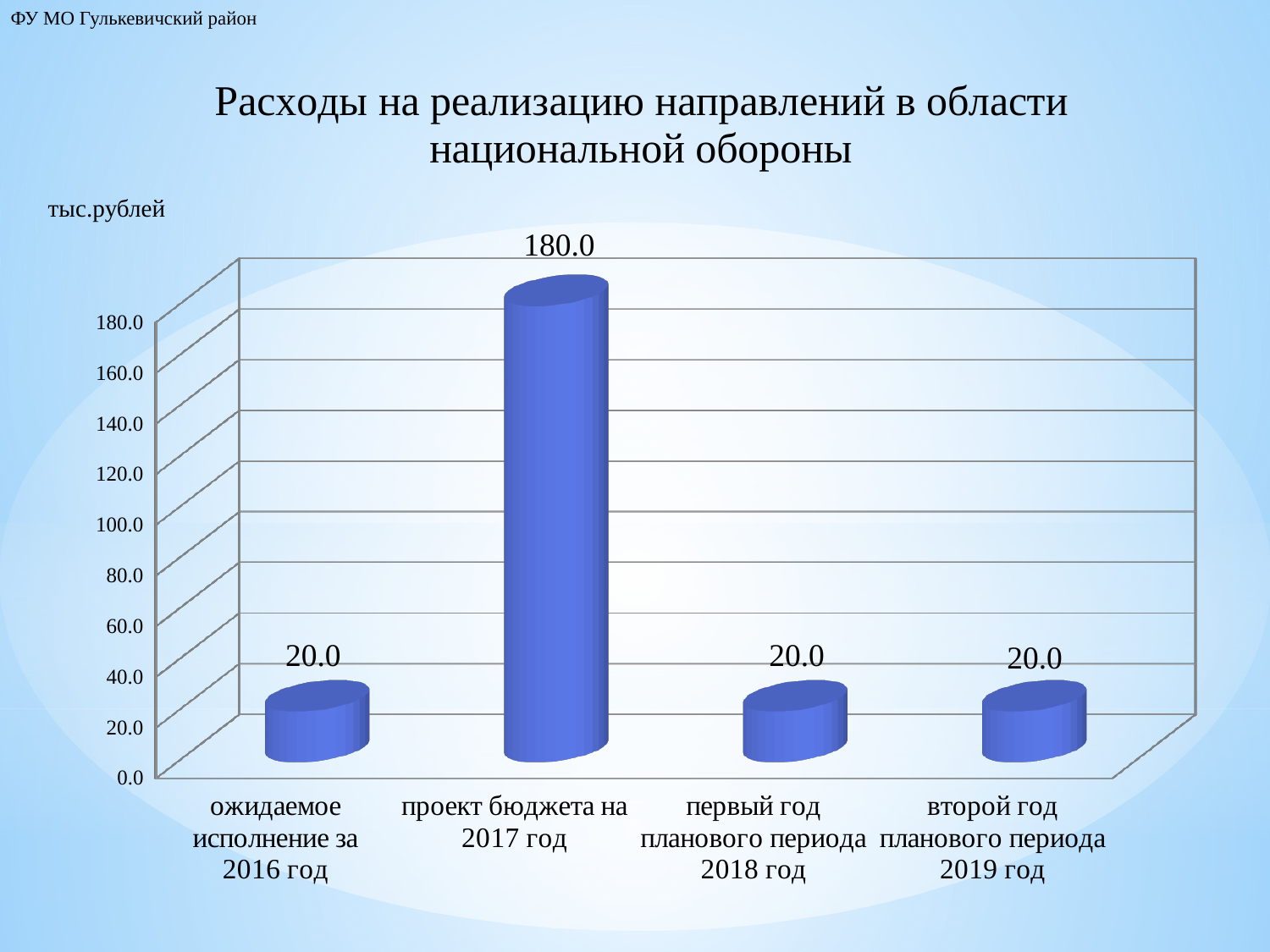
What is the title of the chart? Расходы на реализацию направлений в области национальной обороны Which is larger: the value for 'проект бюджета на 2017 год' or the value for 'второй год планового периода 2019 год'? проект бюджета на 2017 год Which category has the highest value? проект бюджета на 2017 год What is the value for 'проект бюджета на 2017 год'? 180.0 What is the difference between the value for 'проект бюджета на 2017 год' and the value for 'ожидаемое исполнение за 2016 год'? 160.0 How many categories are shown on the x axis? 4 What unit is indicated above the chart? тыс.рублей What is the value for 'ожидаемое исполнение за 2016 год'? 20.0 What kind of chart is shown on the slide? bar chart What is the value for 'первый год планового периода 2018 год'? 20.0 What is the value for 'второй год планового периода 2019 год'? 20.0 Is the value for 'проект бюджета на 2017 год' greater or less than 100.0? greater